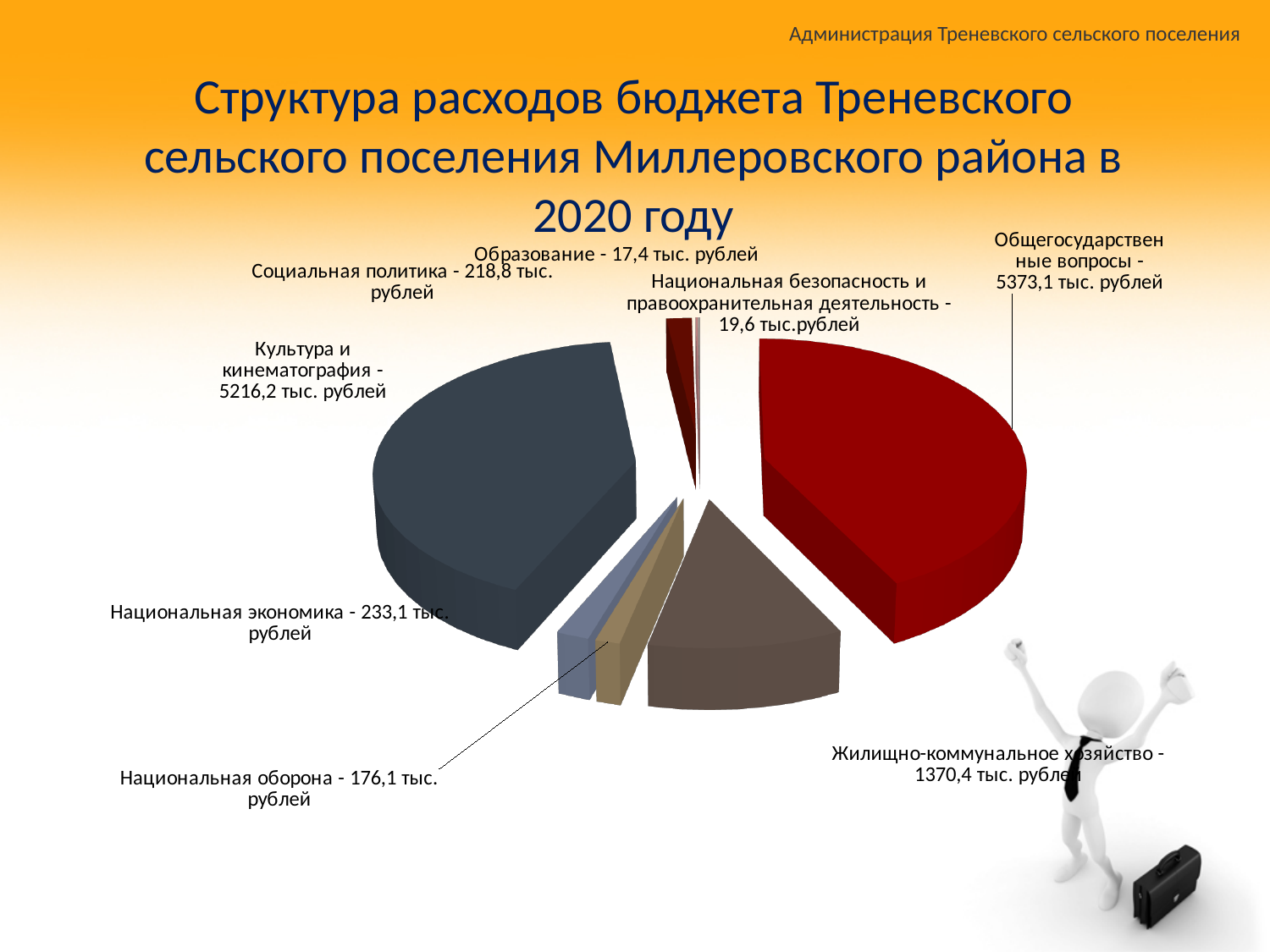
What is the value for Культура и кинематография? 5216,2 тыс. рублей How many categories (slices) does the pie chart show? 8 What is the value for Общегосударственные вопросы? 5373,1 тыс. рублей Which is larger: Национальная экономика or Социальная политика? Национальная экономика Which category has the smallest expenditure? Образование What is the value for Образование? 17,4 тыс. рублей What year does the chart title refer to? 2020 What kind of chart is shown on the slide? pie chart What is the value for Национальная оборона? 176,1 тыс. рублей What is the difference between Общегосударственные вопросы and Культура и кинематография? 156,9 тыс. рублей What is the value for Жилищно-коммунальное хозяйство? 1370,4 тыс. рублей Which category has the largest expenditure? Общегосударственные вопросы